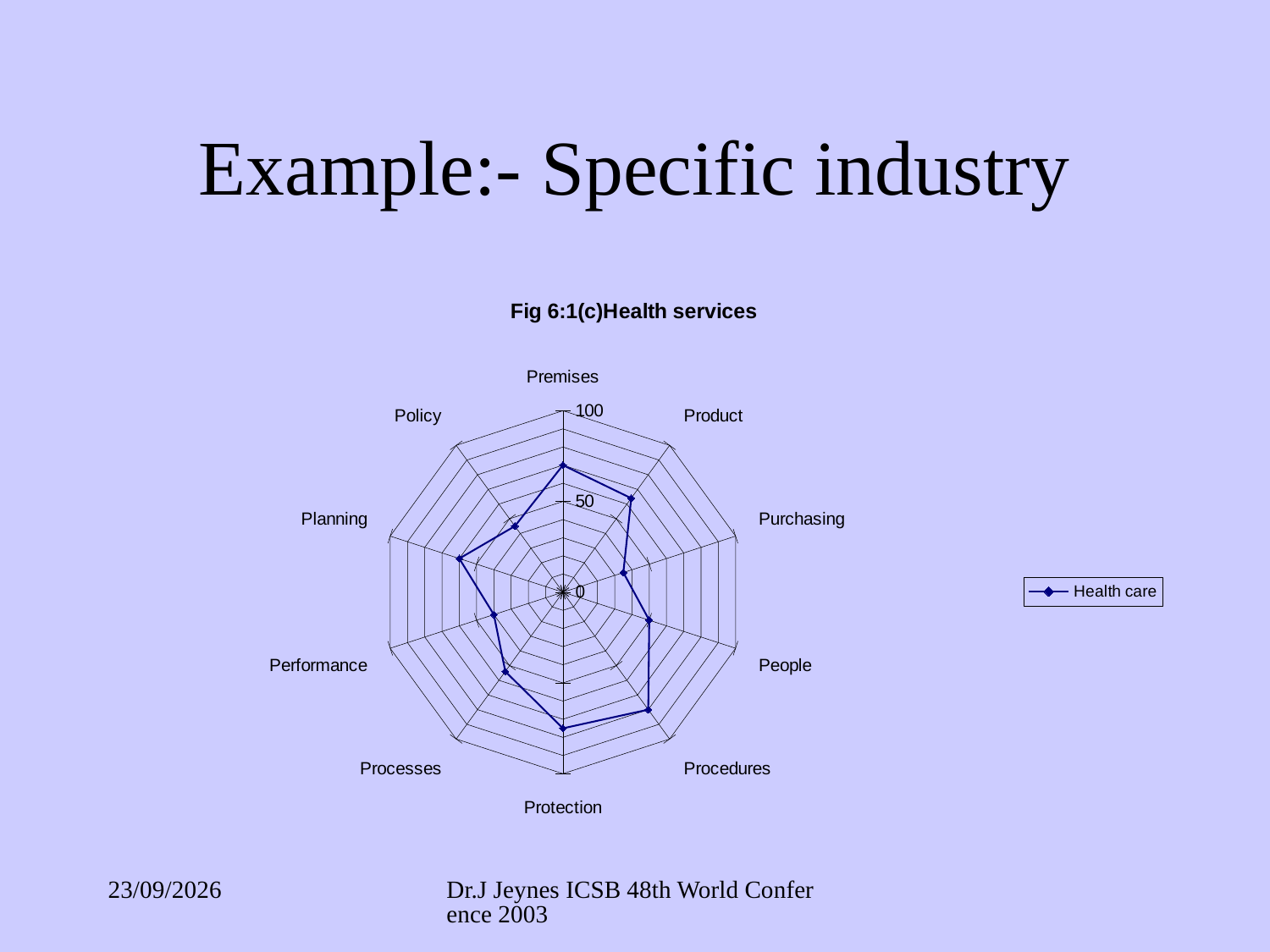
What is the title of the chart? Fig 6:1(c)Health services Is the value for Premises greater or less than 50? greater Which is larger, the value for People or the value for Purchasing? People Is the value for Performance greater or less than 50? less How many series does the legend list? 1 What series name appears in the legend? Health care Which category has the lowest value? Purchasing What kind of chart is shown on the slide? radar chart Is the value for Purchasing greater or less than 50? less Which is larger, the value for Premises or the value for Performance? Premises